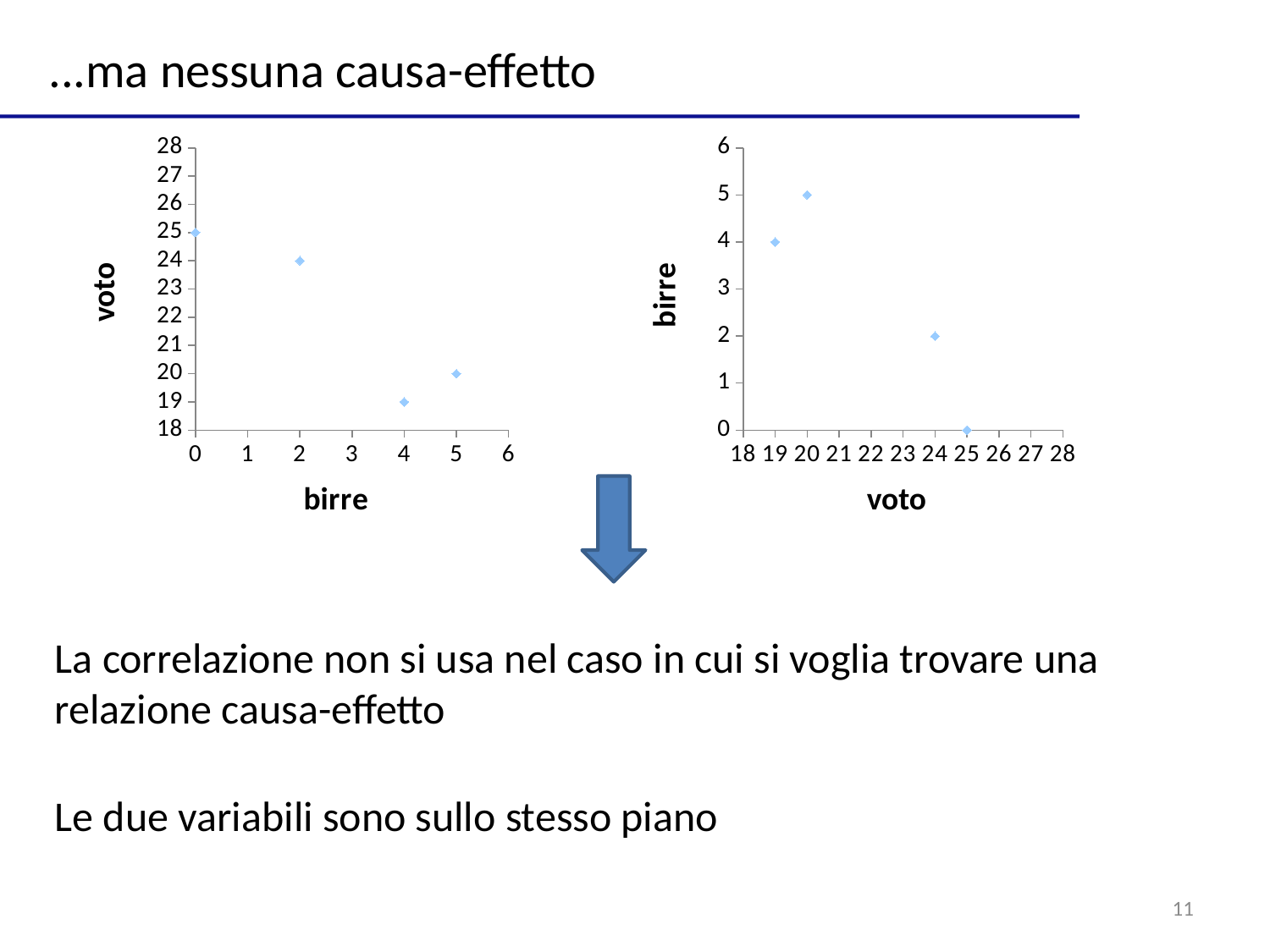
In the left chart (voto vs birre), what is the voto value for the point at birre = 4? 19 In the right chart (birre vs voto), how many data points are plotted? 4 In the left chart (voto vs birre), what is the difference between the voto at birre = 0 and the voto at birre = 5? 5 What kind of chart is the left chart (voto vs birre)? Scatter chart In the left chart (voto vs birre), which birre value has the lowest voto? 4 In the right chart (birre vs voto), do the birre values generally rise or fall as voto increases? Fall What is the label of the x axis of the right chart? voto In the right chart (birre vs voto), what is the birre value for the point at voto = 25? 0 In the left chart (voto vs birre), how many data points are plotted? 4 In the right chart (birre vs voto), what is the birre value for the point at voto = 20? 5 In the right chart (birre vs voto), which voto value has the highest birre? 20 In the left chart (voto vs birre), what is the voto value for the point at birre = 0? 25